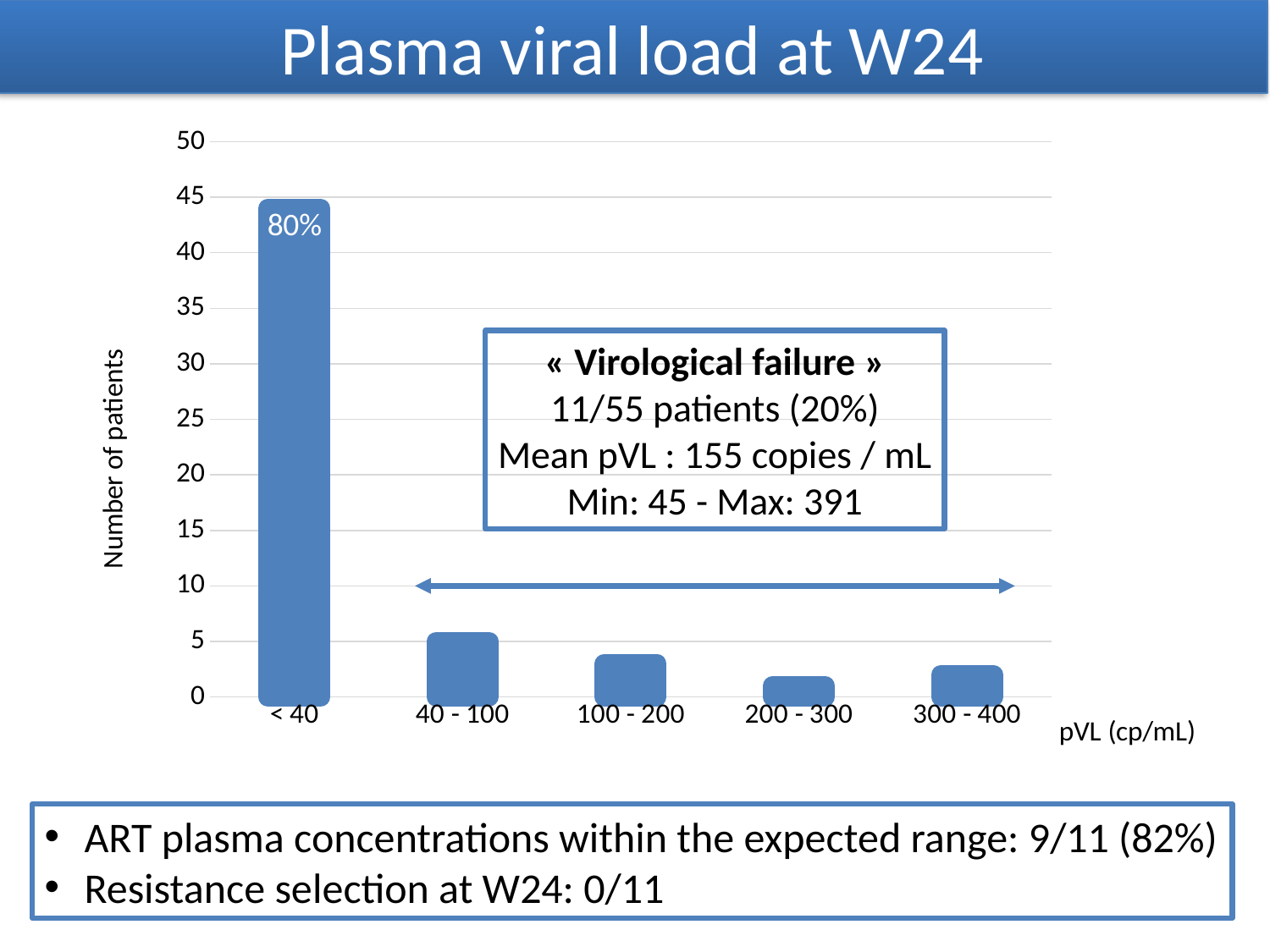
Is the number of patients in the 200 - 300 category greater or less than 5? less Is the number of patients in the 100 - 200 category greater or less than 5? less What type of chart is shown on the slide? bar chart Which pVL category has the lowest number of patients? 200 - 300 What percentage label is printed on the < 40 bar? 80% Is the number of patients in the < 40 category greater or less than 40? greater Which pVL category has the highest number of patients? < 40 What is the title of the y axis of the chart? Number of patients Which category has more patients, < 40 or 300 - 400? < 40 Which category has more patients, 40 - 100 or 100 - 200? 40 - 100 How many pVL categories are shown on the x axis of the chart? 5